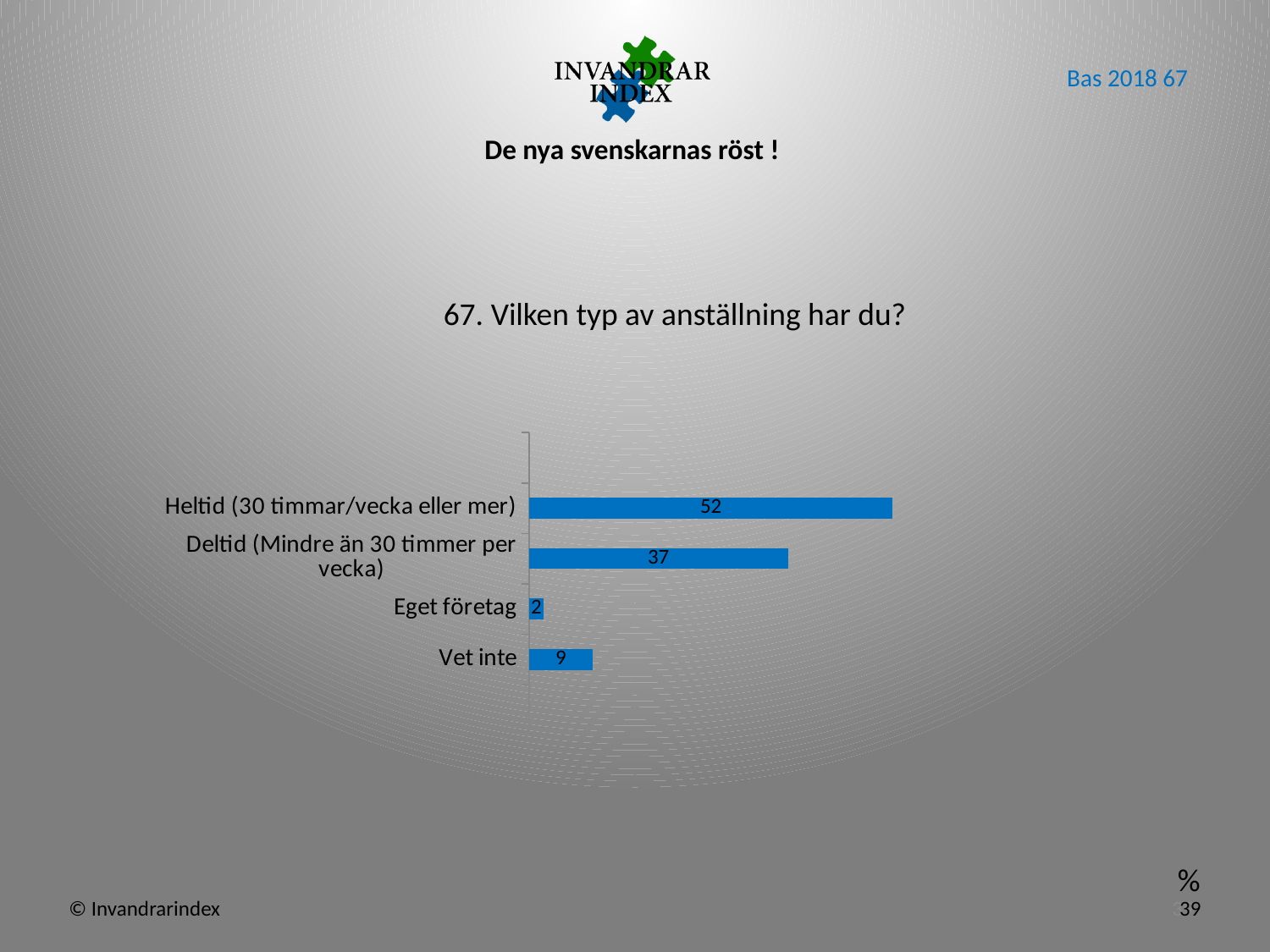
What is the difference between the values for Heltid (30 timmar/vecka eller mer) and Deltid (Mindre än 30 timmer per vecka)? 15 How many categories are shown in the chart? 4 What is the difference between the values for Vet inte and Eget företag? 7 What is the title of the chart? 67. Vilken typ av anställning har du? Which category has the highest value? Heltid (30 timmar/vecka eller mer) What is the value for Eget företag? 2 What is the value for Heltid (30 timmar/vecka eller mer)? 52 What kind of chart is shown on the slide? Bar chart Which is larger, the value for Vet inte or the value for Eget företag? Vet inte Which category has the lowest value? Eget företag What is the value for Deltid (Mindre än 30 timmer per vecka)? 37 What is the value for Vet inte? 9